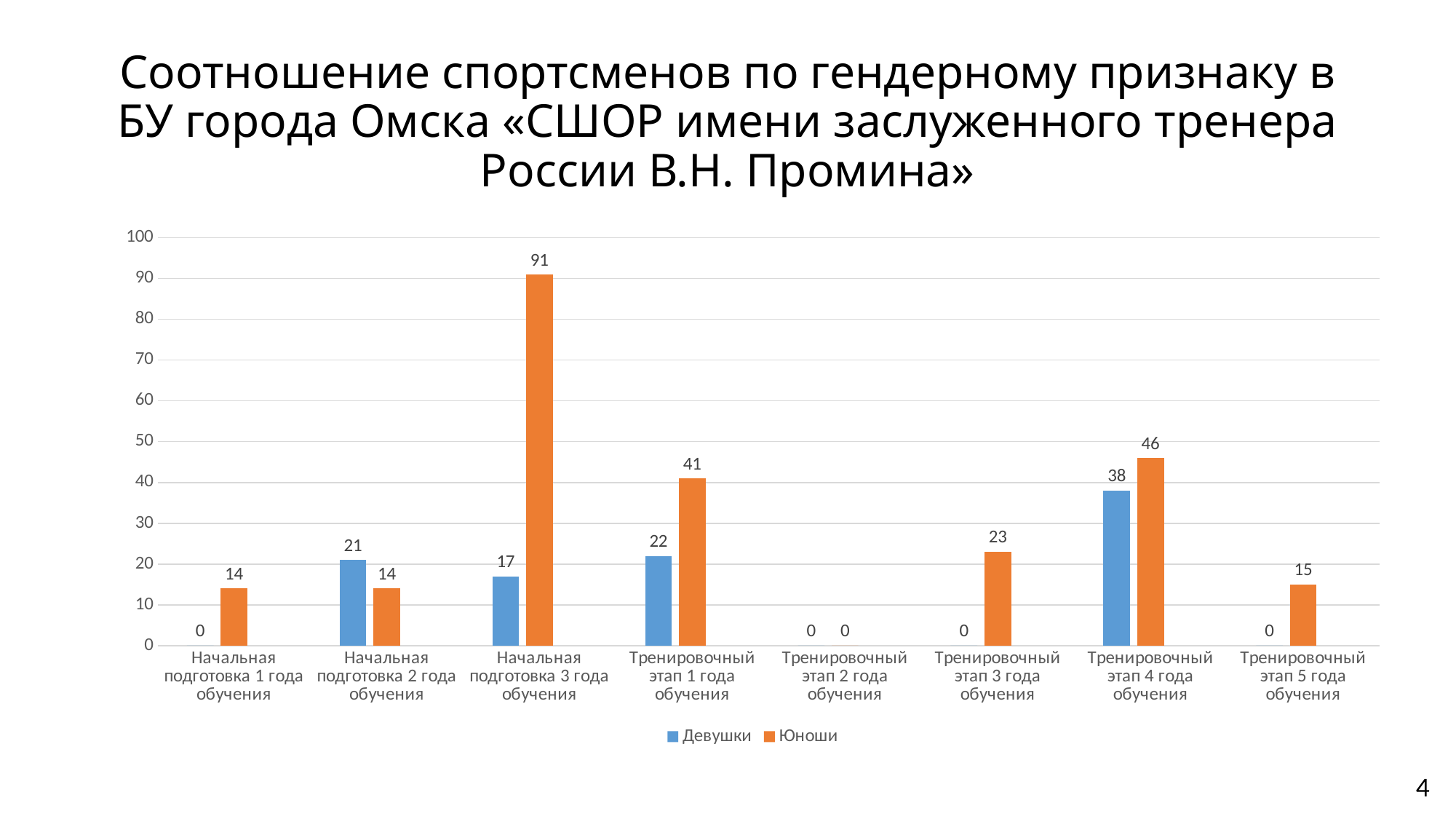
What is the value for Юноши in the category Начальная подготовка 3 года обучения? 91 What is the value for Девушки in the category Начальная подготовка 2 года обучения? 21 Which is larger in the category Начальная подготовка 2 года обучения: Девушки or Юноши? Девушки How many categories are shown on the x axis? 8 What is the value for Юноши in the category Тренировочный этап 2 года обучения? 0 What kind of chart is shown on the slide? Bar chart Which category has the highest value for Девушки? Тренировочный этап 4 года обучения Which category has the highest value for Юноши? Начальная подготовка 3 года обучения How many series does the legend list? 2 What is the value for Девушки in the category Тренировочный этап 4 года обучения? 38 Which colour represents the series Юноши in the legend? Orange What is the difference between Юноши and Девушки in the category Начальная подготовка 3 года обучения? 74